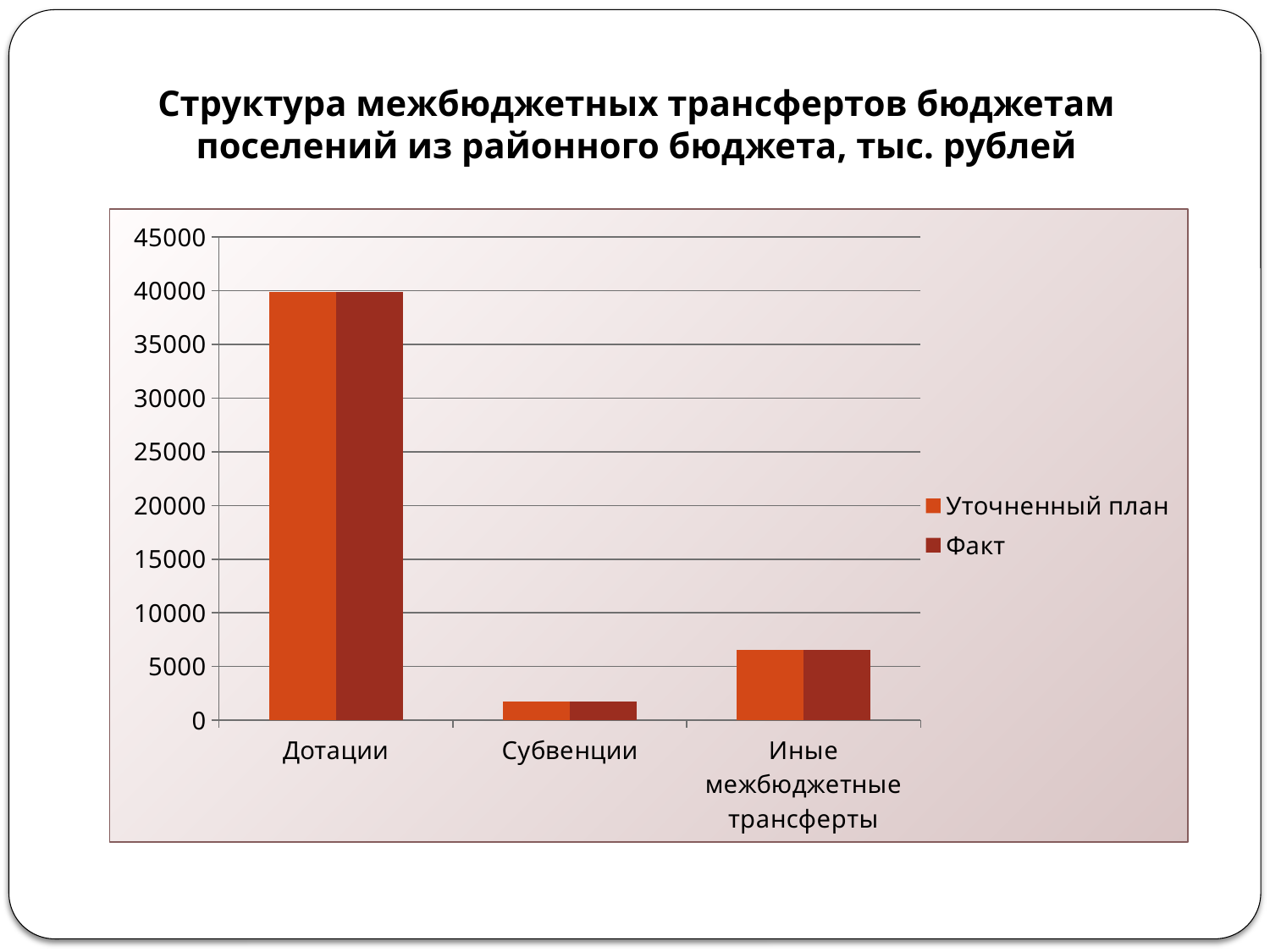
Is the value for Дотации (Уточненный план) greater or less than 35000? greater Which category has the highest value for Уточненный план? Дотации Is the value for Иные межбюджетные трансферты (Уточненный план) greater or less than 5000? greater How many series does the legend list? 2 What are the two series named in the legend? Уточненный план and Факт What kind of chart is shown on the slide? bar chart What is the title of the chart? Структура межбюджетных трансфертов бюджетам поселений из районного бюджета, тыс. рублей How many categories are shown on the x axis of the chart? 3 Is the value for Иные межбюджетные трансферты (Факт) greater or less than 10000? less Which category has the lowest value for Факт? Субвенции Which is larger for Факт: Субвенции or Иные межбюджетные трансферты? Иные межбюджетные трансферты